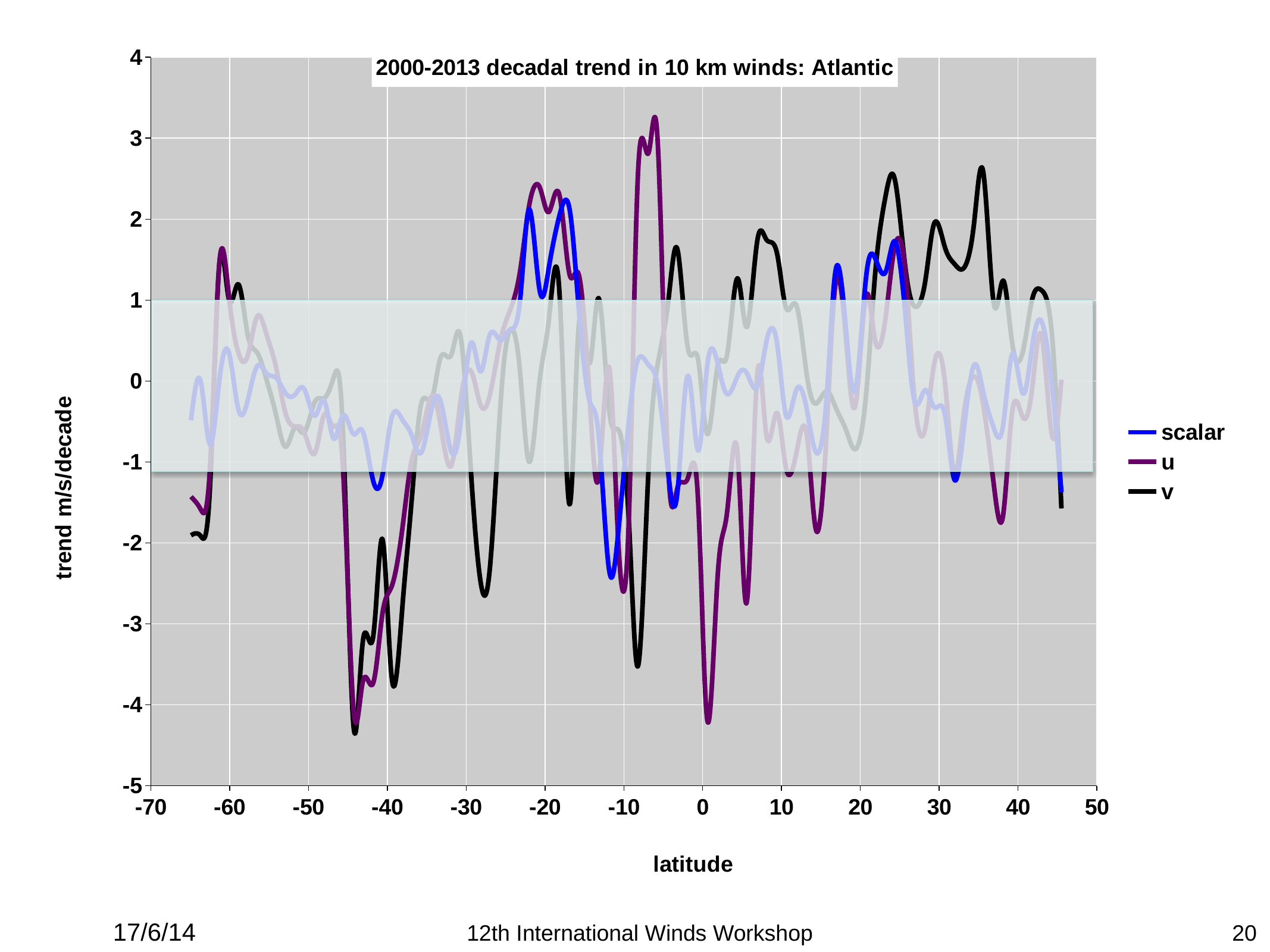
Is the peak value of the v series near latitude 35 greater or less than 2? greater Is the minimum value of the scalar series near latitude -11 greater or less than -2? less Is the minimum value of the v series near latitude -44 greater or less than -4? less What kind of chart is shown on the slide? line chart Which series reaches the highest value anywhere on the chart? u How many series does the legend list? 3 Near latitude -6, which series has the larger value, u or scalar? u What is the label on the y axis of the chart? trend m/s/decade What is the title of the chart? 2000-2013 decadal trend in 10 km winds: Atlantic